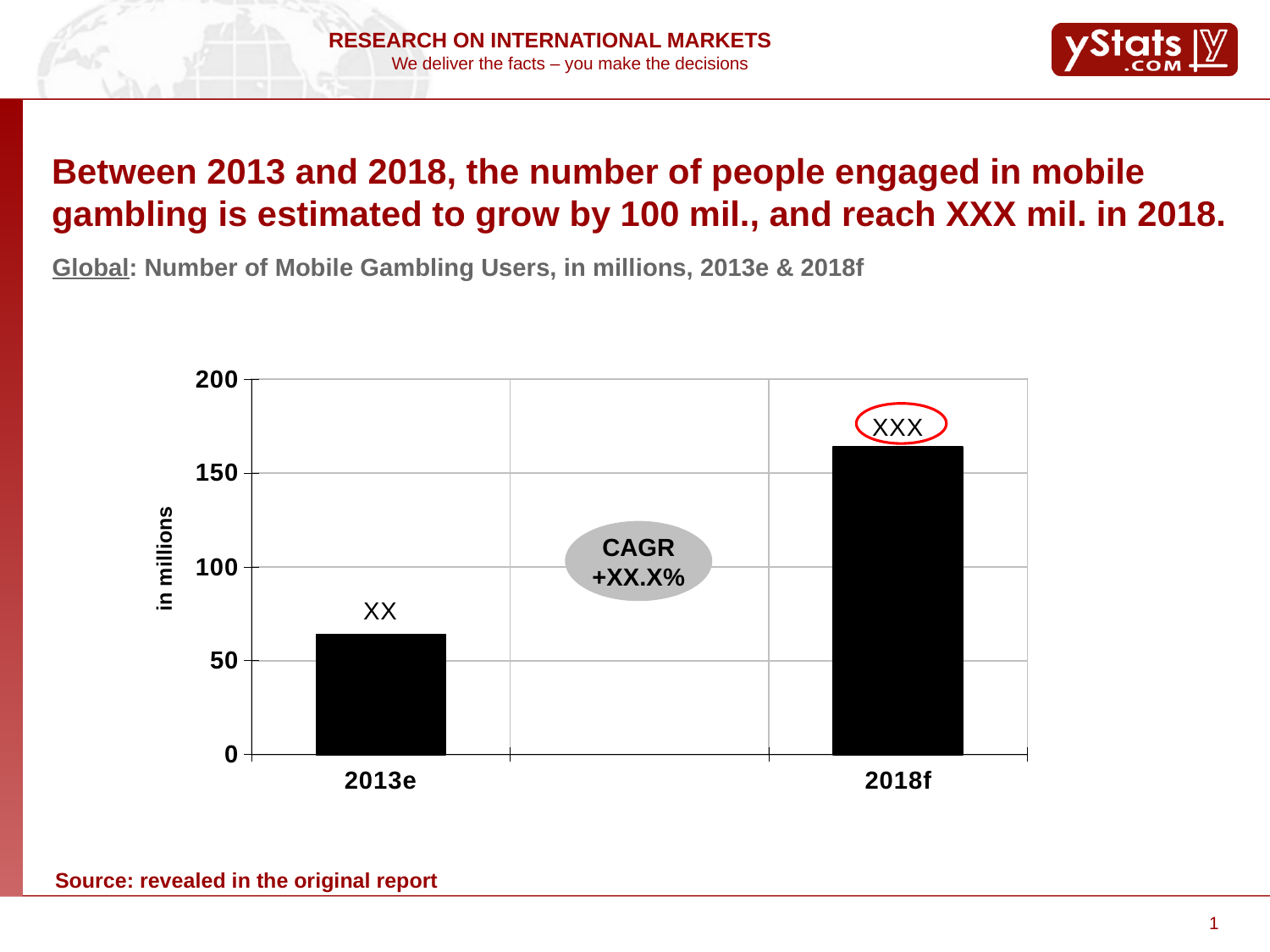
What is the label on the y axis of the chart? in millions Which is larger, the value for 2013e or the value for 2018f? 2018f Is the value for 2013e greater or less than 100? less What is the title of the chart? Global: Number of Mobile Gambling Users, in millions, 2013e & 2018f Is the value for 2013e greater or less than 50? greater How many categories are plotted on the x axis of the chart? 2 Which category has the highest bar in the chart? 2018f Is the value for 2018f greater or less than 200? less Do the values rise or fall from 2013e to 2018f? rise What kind of chart is shown on the slide? bar chart Which category has the lowest bar in the chart? 2013e